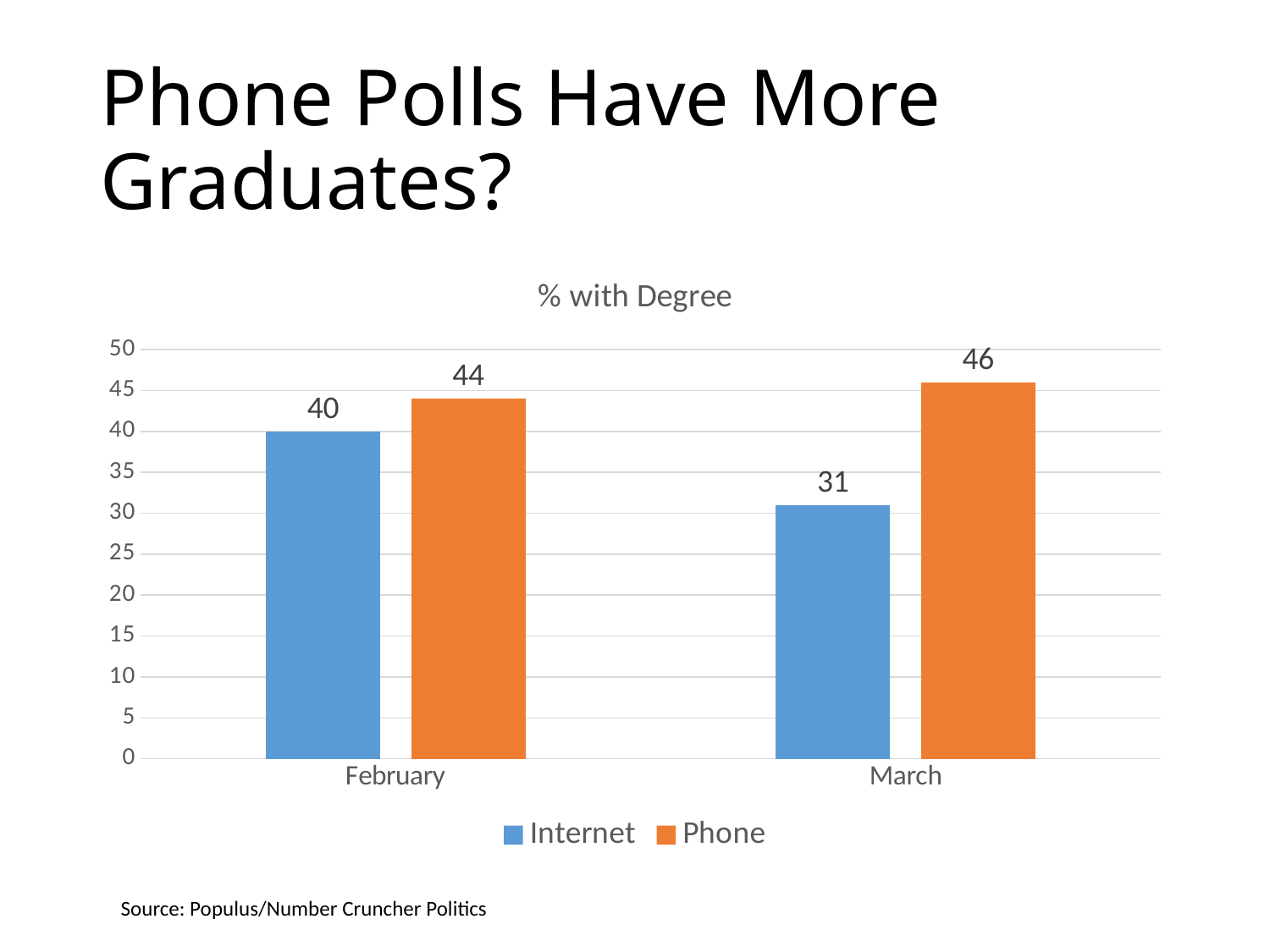
Which bar has the highest value in the chart? Phone, March What is the difference between the Phone and Internet values for March? 15 What is the Phone value for March? 46 Which is larger in February, the Internet value or the Phone value? Phone How many categories are shown on the x axis? 2 What is the Internet value for March? 31 How many series does the legend list? 2 What kind of chart is shown on the slide? Bar chart Which bar has the lowest value in the chart? Internet, March What is the Phone value for February? 44 What is the Internet value for February? 40 What is the title of the chart? % with Degree